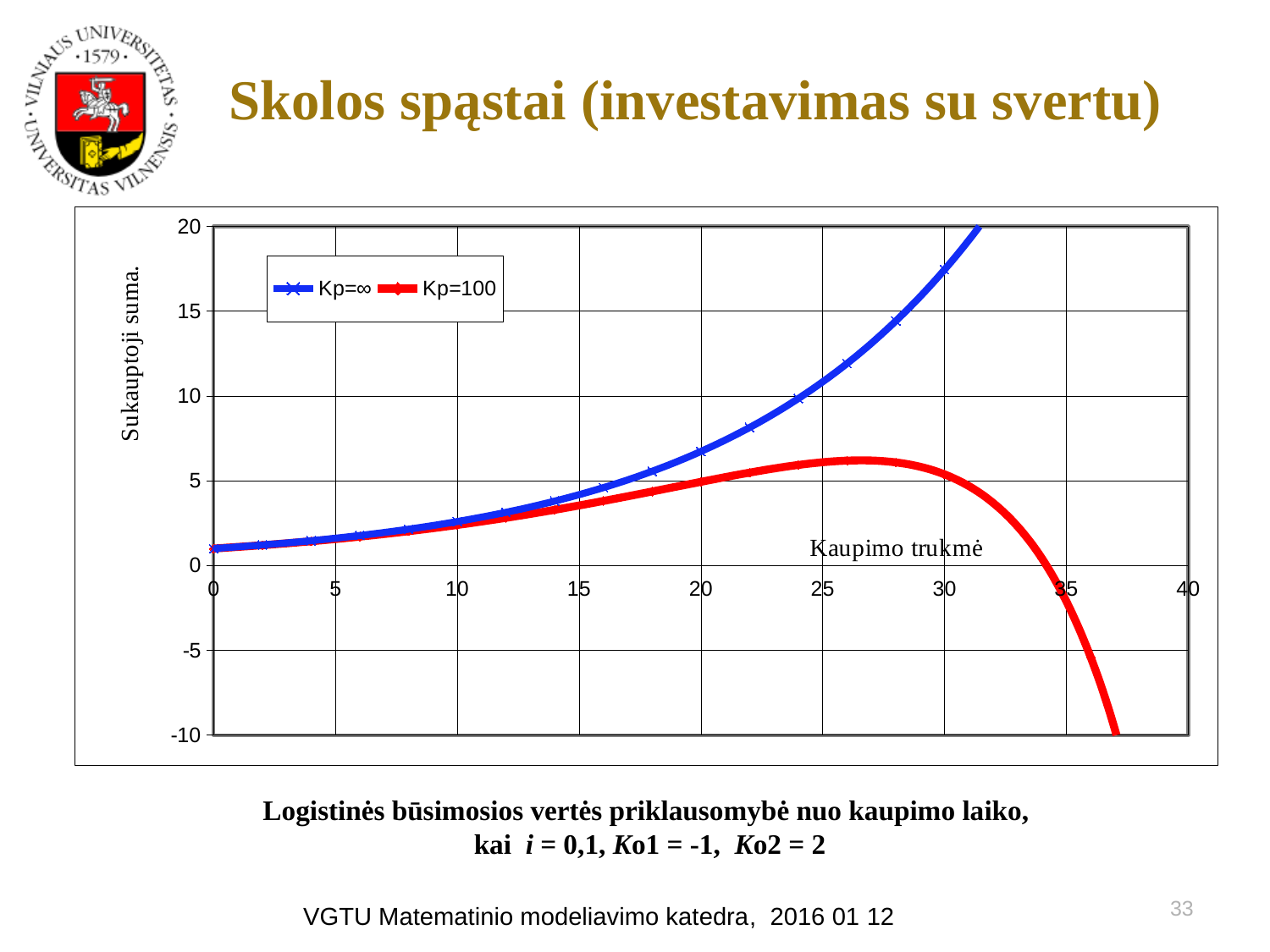
How does the Kp=100 series behave as Kaupimo trukmė increases from 0 to 40? rises, then falls Is the value of the Kp=∞ series at Kaupimo trukmė 30 greater or less than 15? greater At Kaupimo trukmė 30, which series has the higher value, Kp=∞ or Kp=100? Kp=∞ What kind of chart is shown on the slide? line chart Is the peak value of the Kp=100 series greater or less than 10? less How many series does the chart legend list? 2 What is the label of the vertical axis of the chart? Sukauptoji suma Does the Kp=∞ series rise or fall as Kaupimo trukmė increases? rises What are the two series named in the chart legend? Kp=∞ and Kp=100 Is the value of the Kp=∞ series at Kaupimo trukmė 20 greater or less than 5? greater Which series reaches the top of the chart (20) before Kaupimo trukmė 35? Kp=∞